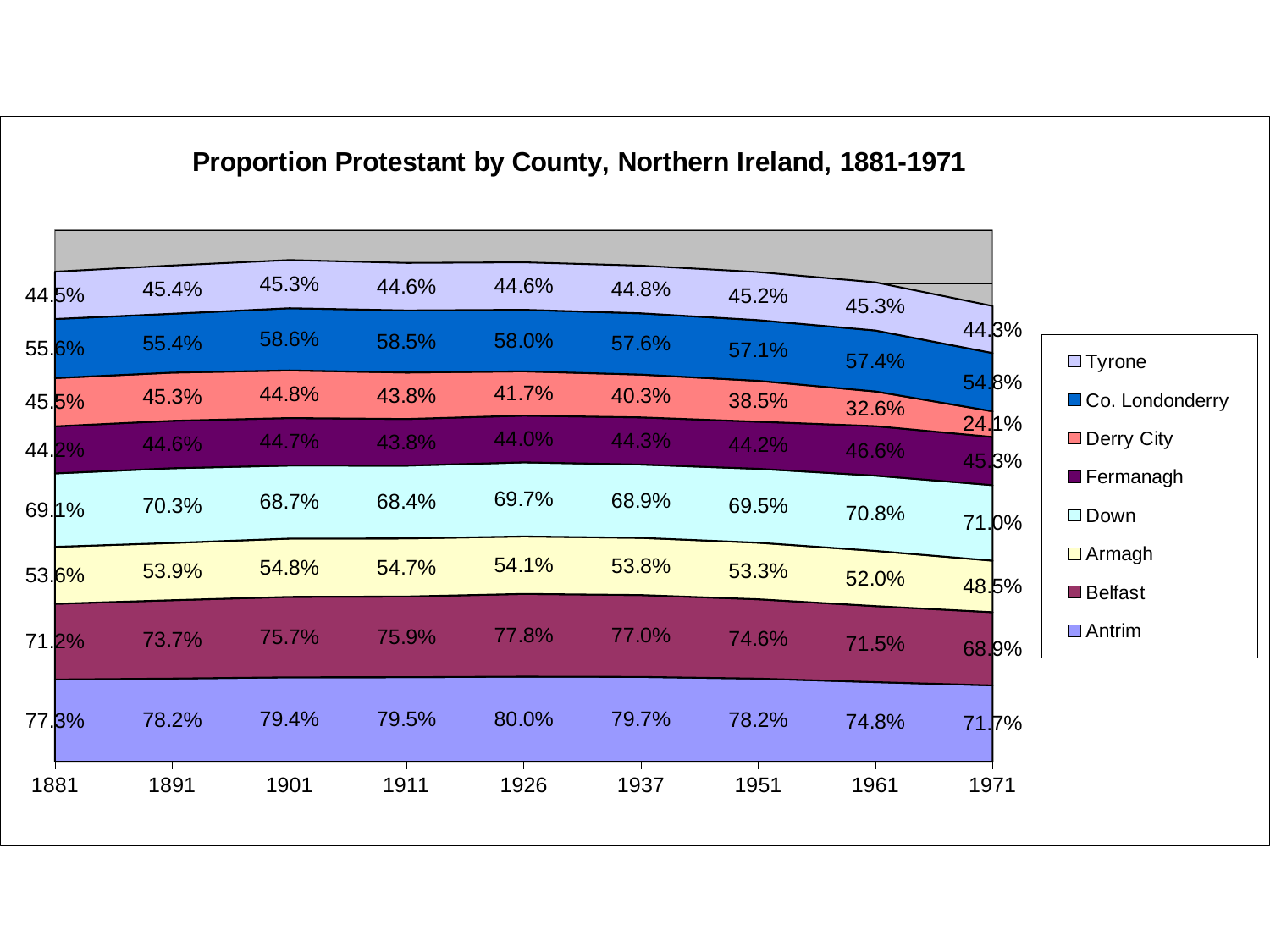
Does the value for Derry City rise or fall from 1881 to 1971? Fall What is the value for Antrim in 1926? 80.0% What is the value for Derry City in 1971? 24.1% What kind of chart is shown on the slide? Stacked area chart What is the title of the chart? Proportion Protestant by County, Northern Ireland, 1881-1971 How many years are shown along the x axis? 9 What is the value for Belfast in 1911? 75.9% In which year is the value for Derry City lowest? 1971 How many series does the legend list? 8 In which year is the value for Belfast highest? 1926 Which is larger in 1961: the value for Down or the value for Armagh? Down What is the difference between the Antrim values in 1926 and 1971? 8.3%